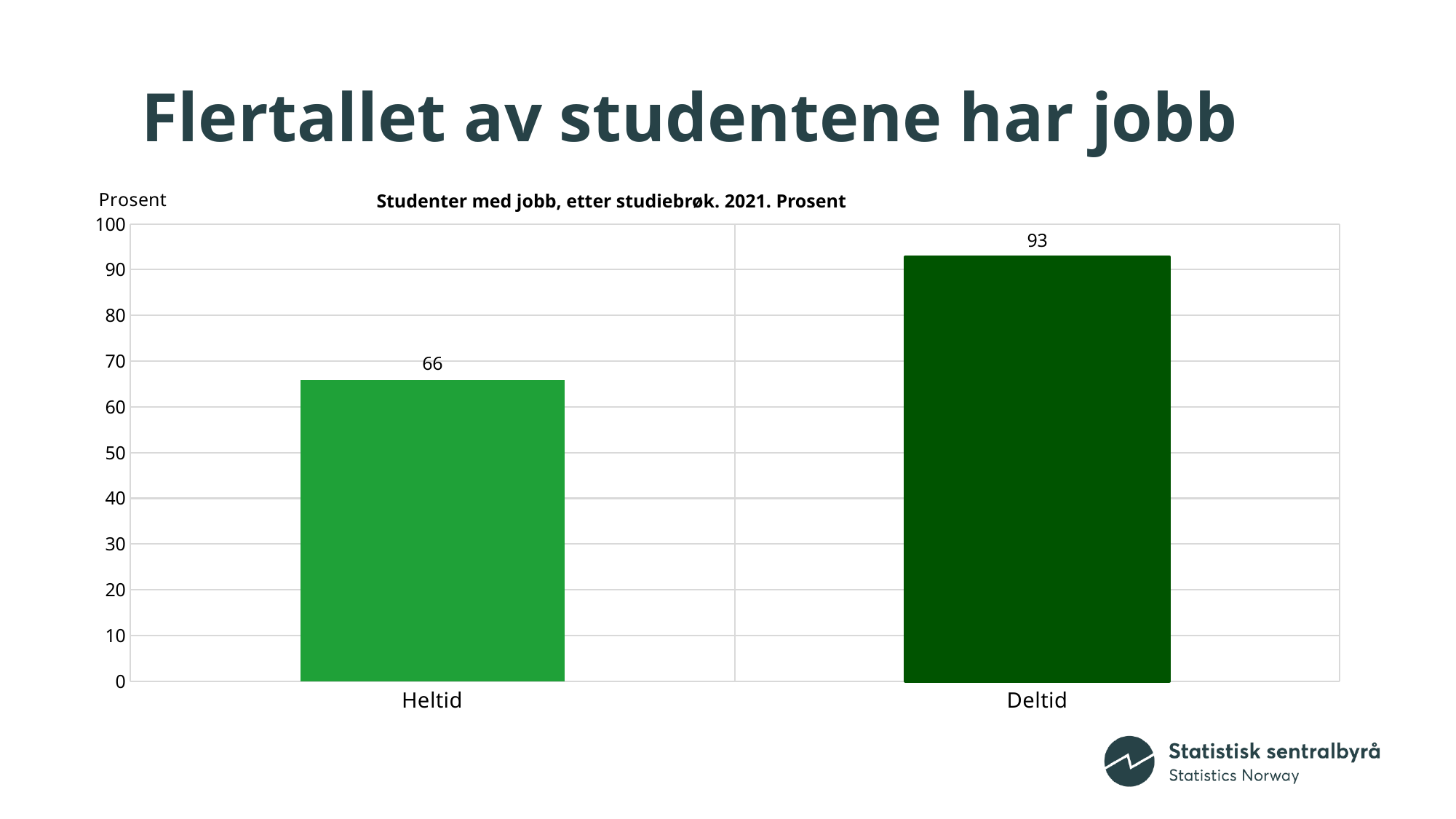
Is the value for Heltid greater or less than 70? less What is the difference between the values for Deltid and Heltid? 27 How many categories are shown on the x axis? 2 What is the value for Deltid? 93 What kind of chart is shown on the slide? bar chart Which is larger, the value for Heltid or the value for Deltid? Deltid What is the label on the vertical axis? Prosent Is the value for Deltid greater or less than 90? greater Which category has the lowest value? Heltid What is the value for Heltid? 66 Which category has the highest value? Deltid What is the title of the chart? Studenter med jobb, etter studiebrøk. 2021. Prosent